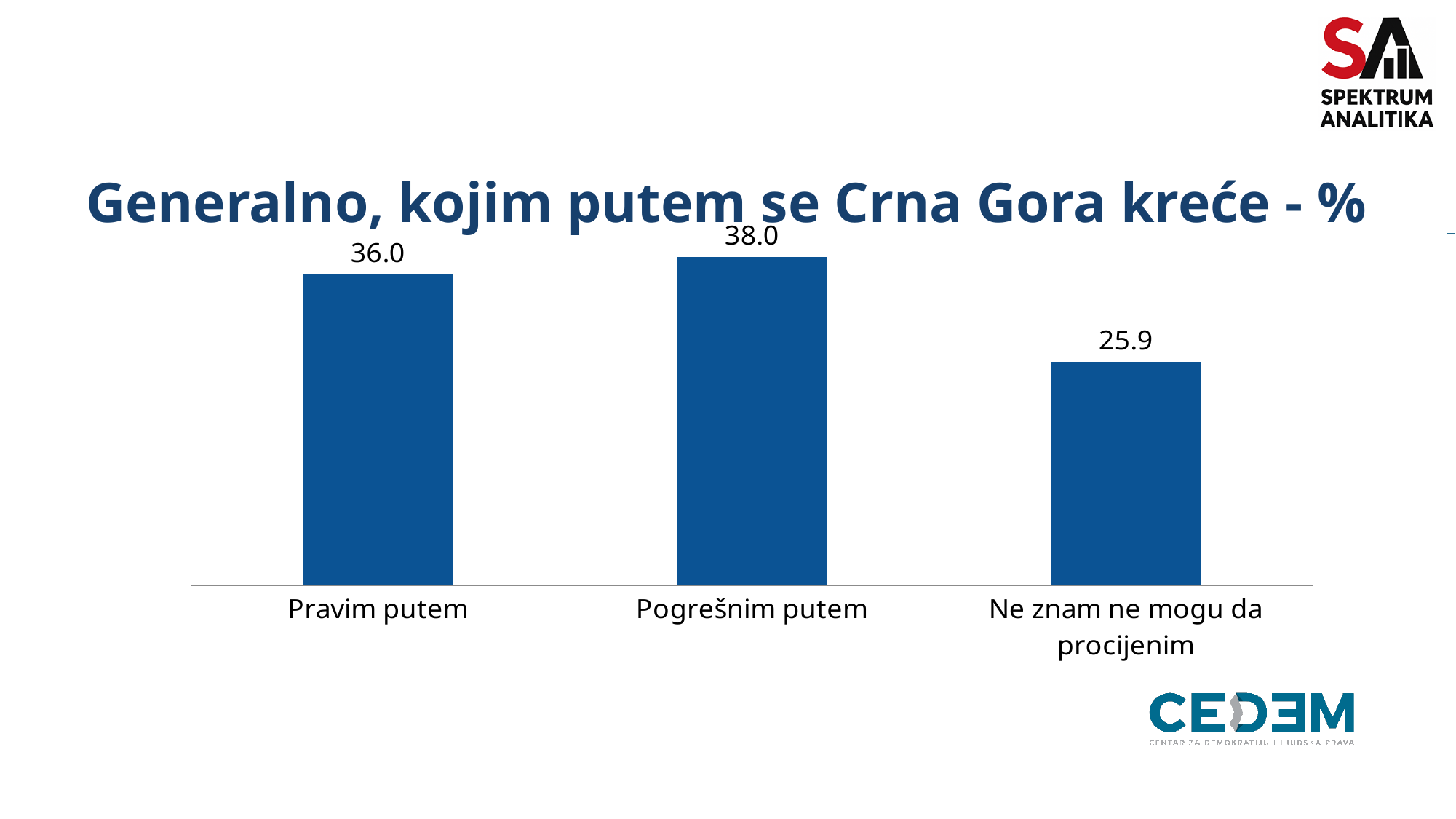
Which category has the highest value? Pogrešnim putem Which category has the lowest value? Ne znam ne mogu da procijenim What is the value for "Pogrešnim putem"? 38.0 What kind of chart is shown on the slide? Bar chart Which is larger, the value for "Pravim putem" or the value for "Ne znam ne mogu da procijenim"? Pravim putem What is the difference between the values for "Pogrešnim putem" and "Pravim putem"? 2.0 How many categories are shown in the chart? 3 What is the title of the chart? Generalno, kojim putem se Crna Gora kreće - % What is the difference between the values for "Pravim putem" and "Ne znam ne mogu da procijenim"? 10.1 What is the value for "Pravim putem"? 36.0 What is the value for "Ne znam ne mogu da procijenim"? 25.9 What colour are the bars in the chart? Blue